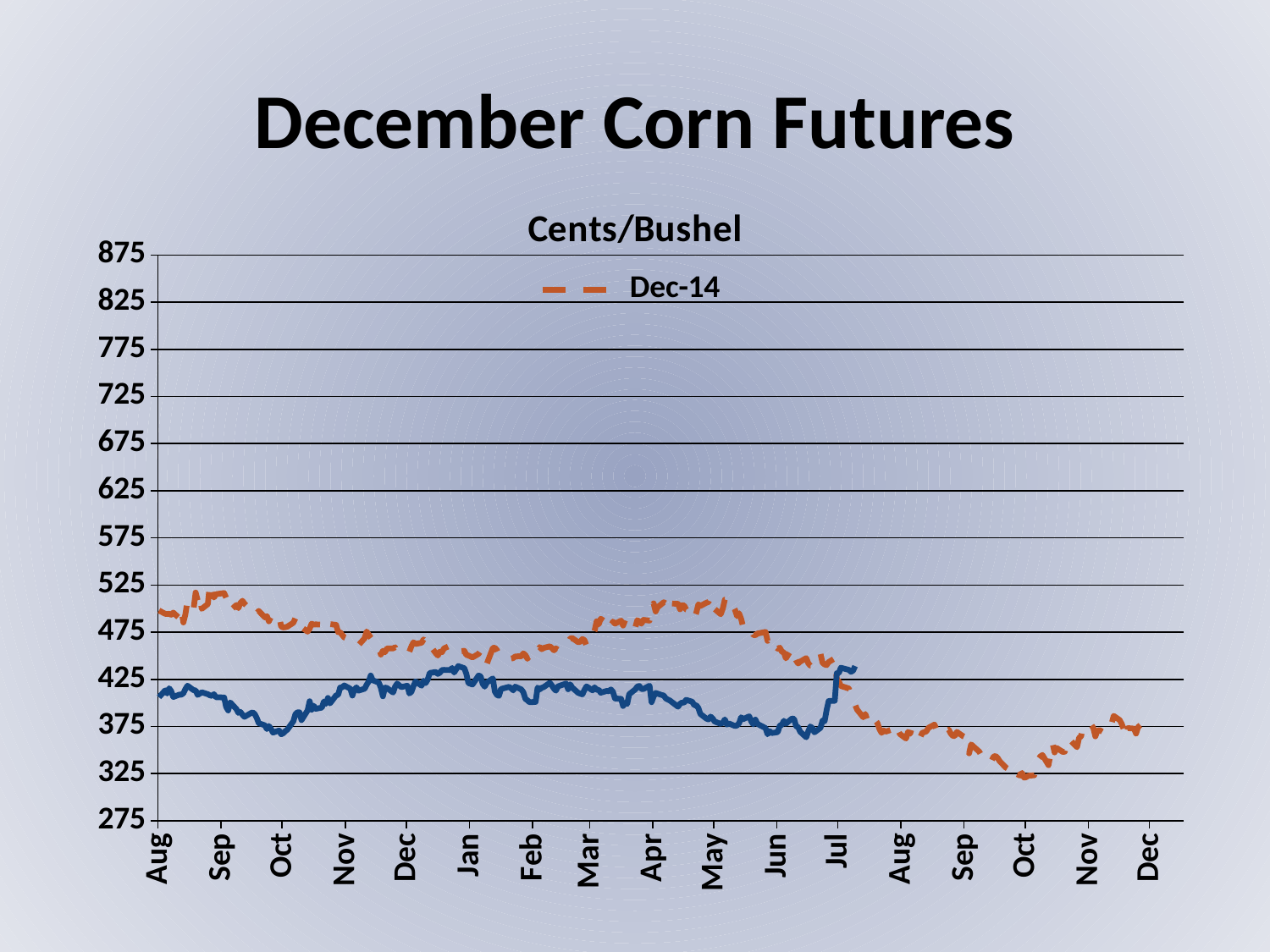
Is the Dec-14 value at the second Oct label greater or less than 375? less Is the Dec-14 value at Apr greater or less than 475? greater At which x-axis label does the Dec-14 series reach its lowest point? Oct (the second Oct) What unit is shown in the chart's subtitle? Cents/Bushel What is the title of the chart on the slide? Cents/Bushel Is the Dec-14 value at the second Sep label greater or less than 425? less What kind of chart is shown on the slide? line chart At the first Aug label, which series is higher: the dashed Dec-14 line or the solid blue line? Dec-14 Does the Dec-14 series rise or fall between Apr and the second Oct label? fall How many month labels are shown along the x axis? 17 How many series does the chart's legend list? 1